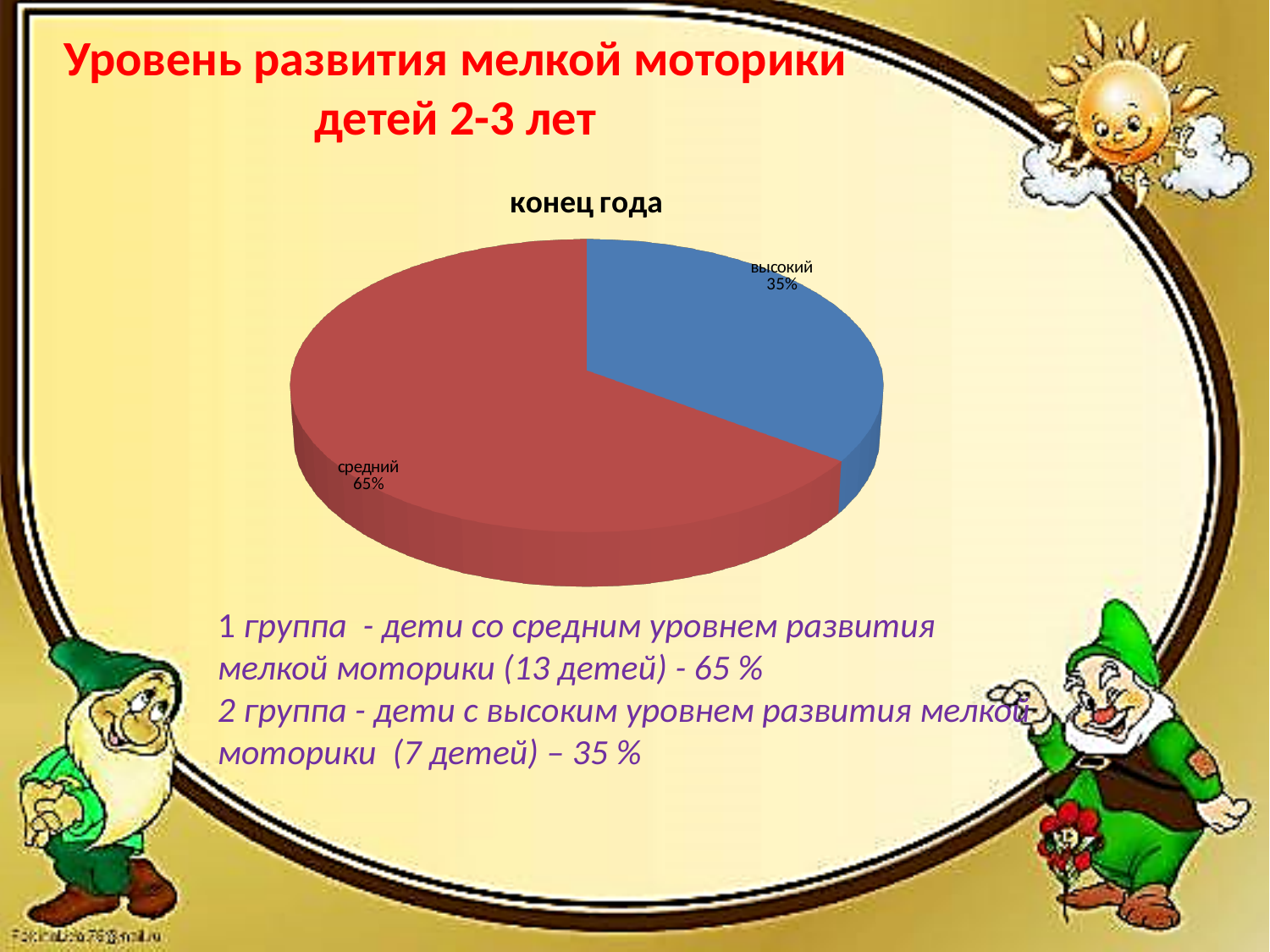
Which is larger, the "средний" slice or the "высокий" slice? средний How many slices does the pie chart have? 2 What colour is the "средний" slice? red What share of the pie does the "средний" slice represent? 65% What kind of chart is shown on the slide? pie chart Is the share for "высокий" greater or less than 50%? less What is the difference in percentage points between the "средний" and "высокий" slices? 30 What is the title of the chart? конец года Which slice of the pie is the largest? средний What share of the pie does the "высокий" slice represent? 35% Which slice of the pie is the smallest? высокий